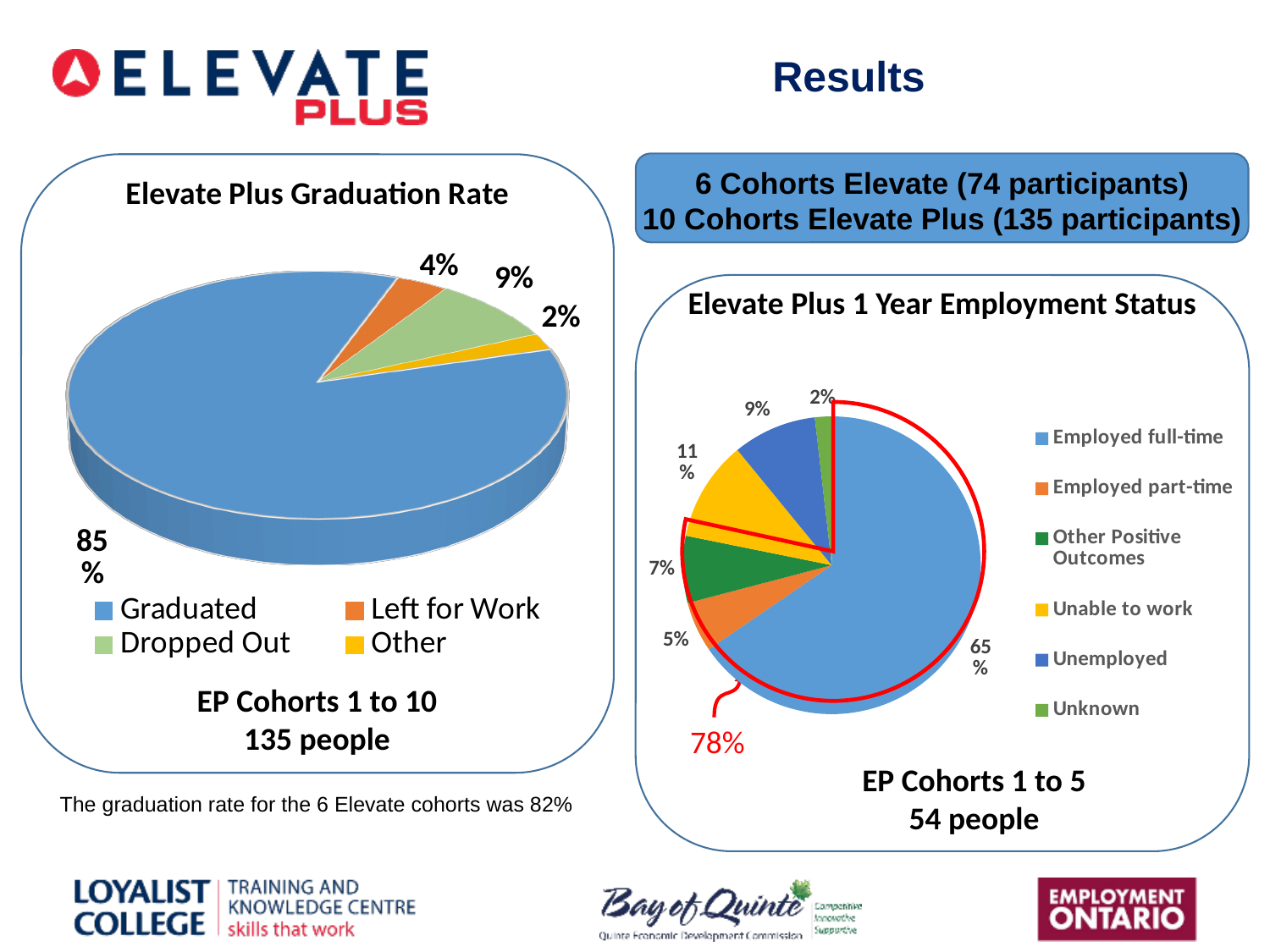
In the Elevate Plus Graduation Rate chart, what percentage of participants graduated? 85% In the Elevate Plus 1 Year Employment Status chart, what is the value for Unable to work? 11% In the Elevate Plus 1 Year Employment Status chart, what percentage were Employed full-time? 65% In the Elevate Plus 1 Year Employment Status chart, which category has the largest slice? Employed full-time In the Elevate Plus 1 Year Employment Status chart, which is larger: Unemployed or Employed part-time? Unemployed In the Elevate Plus Graduation Rate chart, what is the value for Left for Work? 4% In the Elevate Plus Graduation Rate chart, which category has the smallest slice? Other In the Elevate Plus Graduation Rate chart, what share of the pie is Dropped Out? 9% In the Elevate Plus 1 Year Employment Status chart, what is the difference between Unable to work and Other Positive Outcomes? 4% In the Elevate Plus Graduation Rate chart, how many categories does the legend list? 4 In the Elevate Plus 1 Year Employment Status chart, how many categories does the legend list? 6 What kind of chart is the Elevate Plus Graduation Rate chart? Pie chart